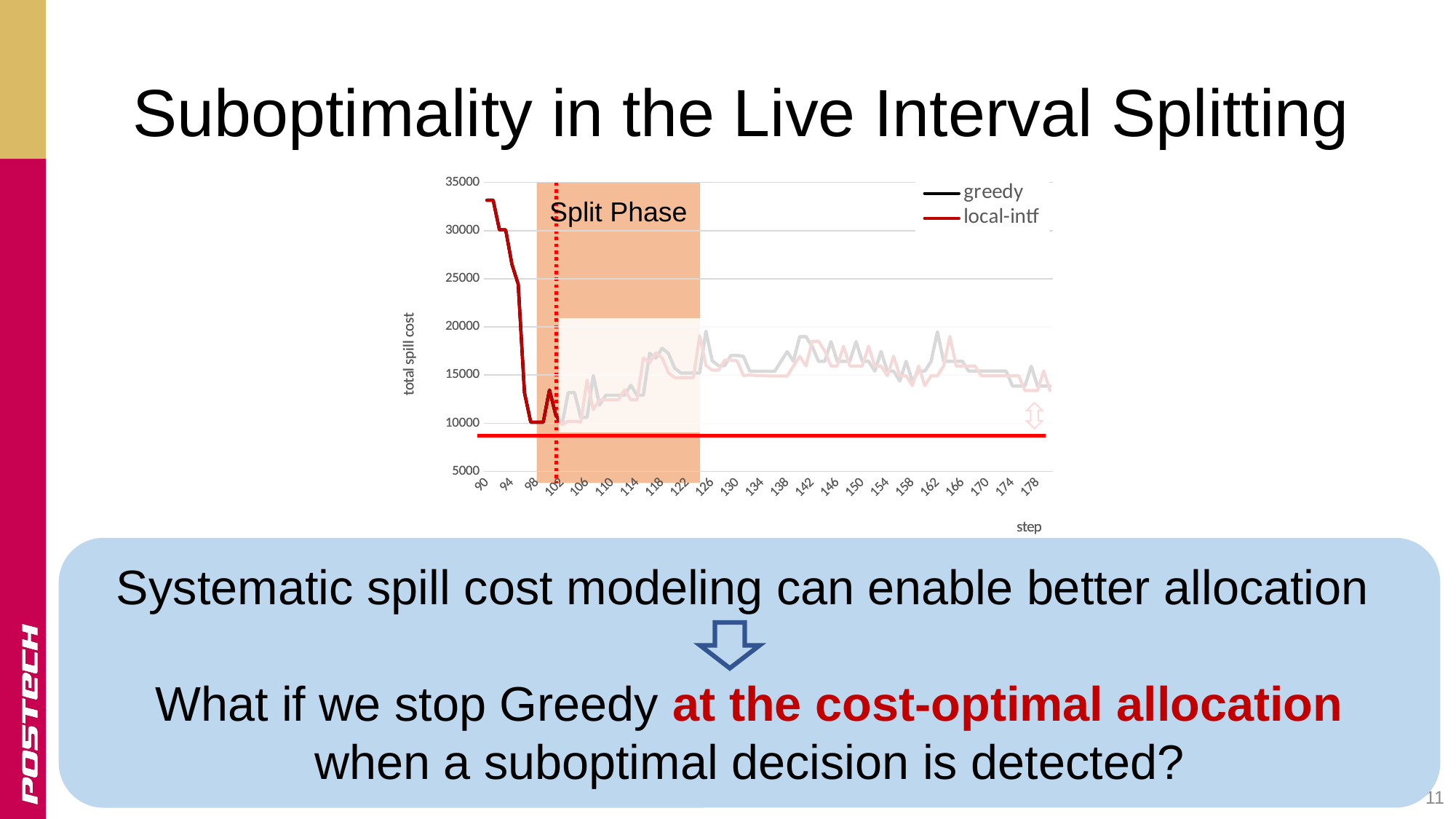
What is the label of the chart's vertical axis? total spill cost Do the values rise or fall between step 90 and step 98? fall Is the value of the lines at step 110 greater or less than 15000? less What are the two series named in the chart legend? greedy and local-intf What is the last step value shown on the horizontal axis? 178 Is the greedy value at step 162 greater or less than 15000? greater How many series does the chart legend list? 2 Is the value of the lines at step 90 greater or less than 30000? greater What kind of chart is shown on the slide? line chart Overall, do the values rise or fall from step 90 to step 178? fall